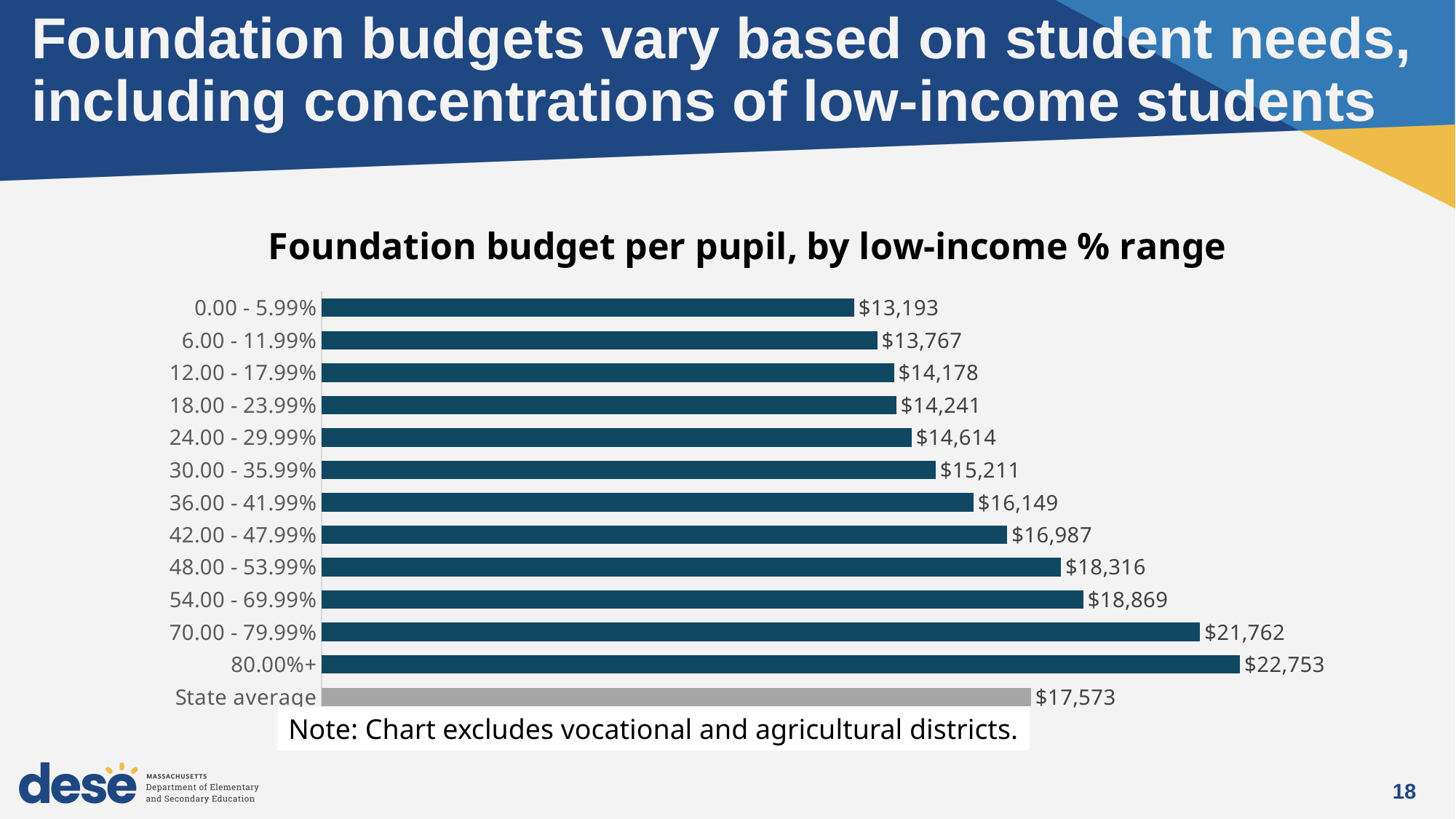
Which low-income % range has the lowest foundation budget per pupil? 0.00 - 5.99% What is the foundation budget per pupil for the 80.00%+ low-income range? $22,753 How many bars are shown on the chart, including the State average? 13 What is the difference between the foundation budget per pupil for the 80.00%+ range and the 0.00 - 5.99% range? $9,560 What is the difference between the foundation budget per pupil for the 70.00 - 79.99% range and the State average? $4,189 Which is larger: the foundation budget per pupil for the 36.00 - 41.99% range or the 42.00 - 47.99% range? 42.00 - 47.99% What is the foundation budget per pupil for the 0.00 - 5.99% low-income range? $13,193 What is the foundation budget per pupil for the 48.00 - 53.99% range? $18,316 What type of chart is shown on the slide? Bar chart What is the State average foundation budget per pupil shown on the chart? $17,573 Which low-income % range has the highest foundation budget per pupil? 80.00%+ Do the foundation budget per pupil values rise or fall as the low-income % range increases? Rise